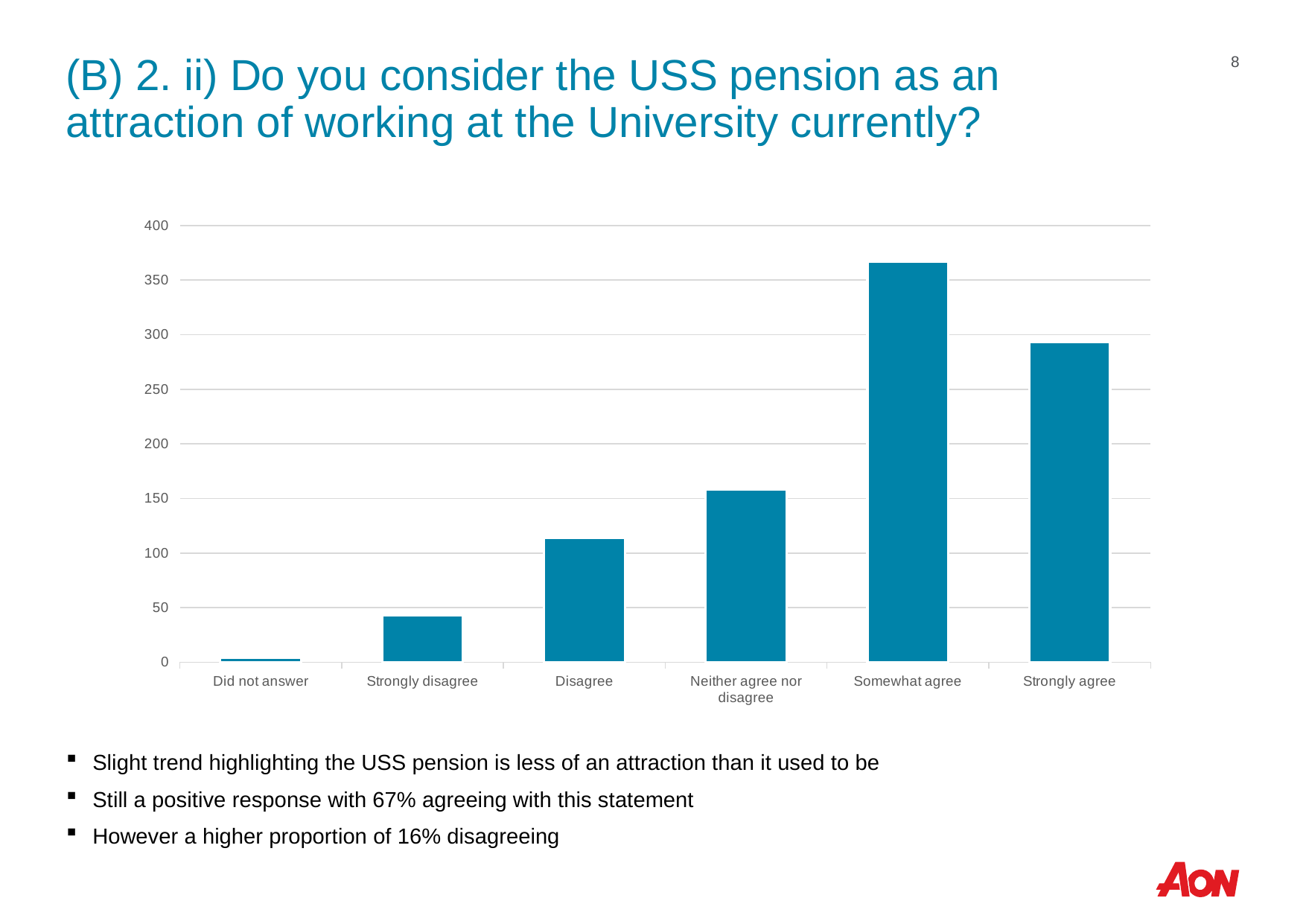
Is the value for Strongly agree greater or less than 250? greater Is the value for Strongly disagree greater or less than 50? less Which response category has the lowest bar? Did not answer How many response categories are shown on the x axis of the chart? 6 Is the value for Disagree greater or less than 100? greater Which response category has the highest bar? Somewhat agree What is the highest value shown on the chart's vertical axis? 400 Do the bars rise or fall from Did not answer through to Somewhat agree? rise What kind of chart is shown on the slide? bar chart Which is larger, the value for Somewhat agree or the value for Strongly agree? Somewhat agree Which is larger, the value for Disagree or the value for Neither agree nor disagree? Neither agree nor disagree